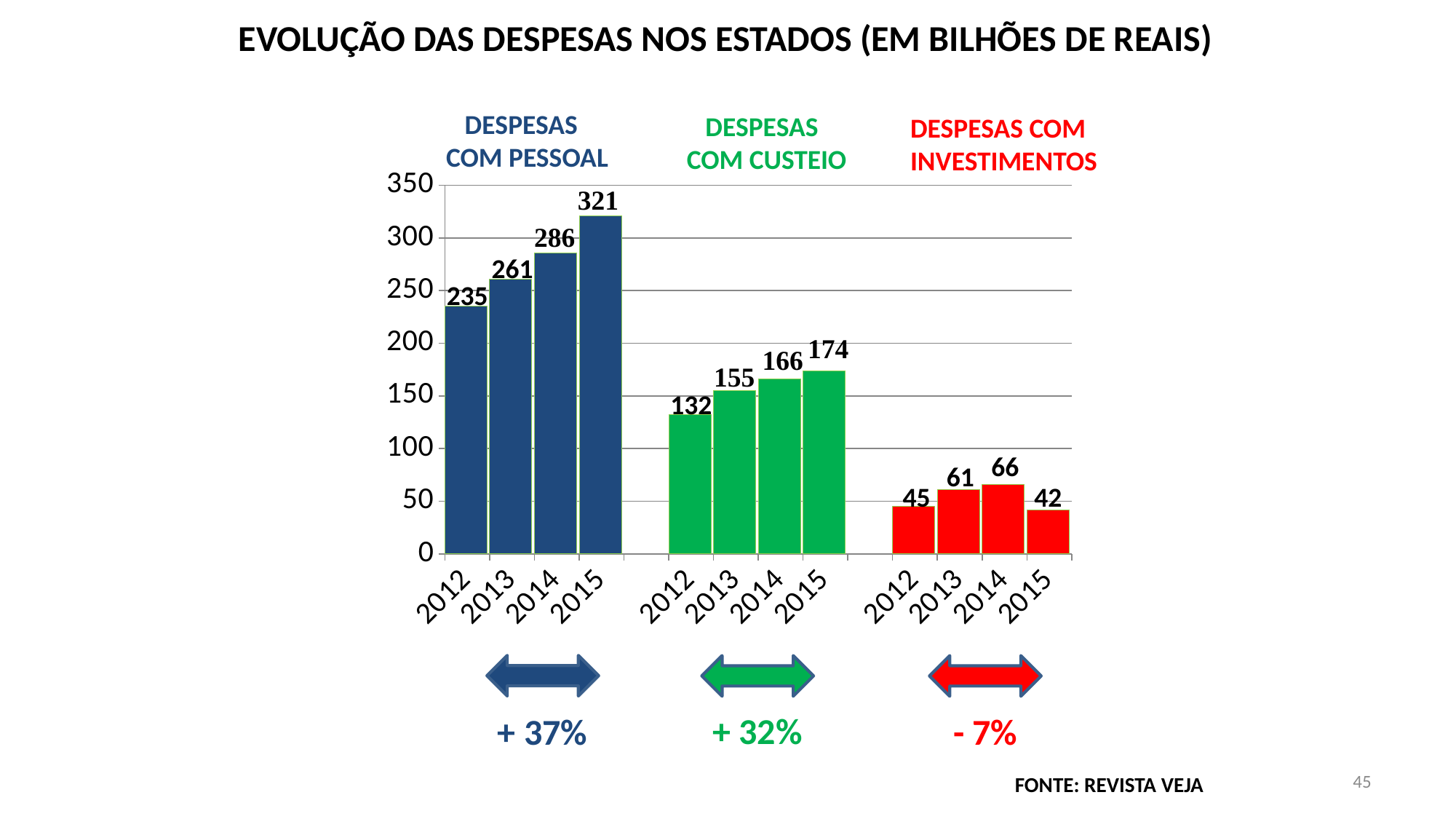
Which is larger: Despesas com Investimentos in 2013 or in 2015? 2013 How many bars are plotted in the chart in total? 12 Do the values for Despesas com Pessoal rise or fall from 2012 to 2015? Rise Is the value for Despesas com Custeio in 2015 greater or less than 150? greater What is the difference between Despesas com Pessoal in 2015 and in 2012? 86 Which year has the lowest value for Despesas com Pessoal? 2012 What is the value for Despesas com Pessoal in 2015? 321 What is the value for Despesas com Custeio in 2012? 132 What is the value for Despesas com Investimentos in 2014? 66 What is the difference between Despesas com Custeio in 2014 and in 2013? 11 What kind of chart is shown on the slide? Bar chart Which year has the highest value for Despesas com Investimentos? 2014